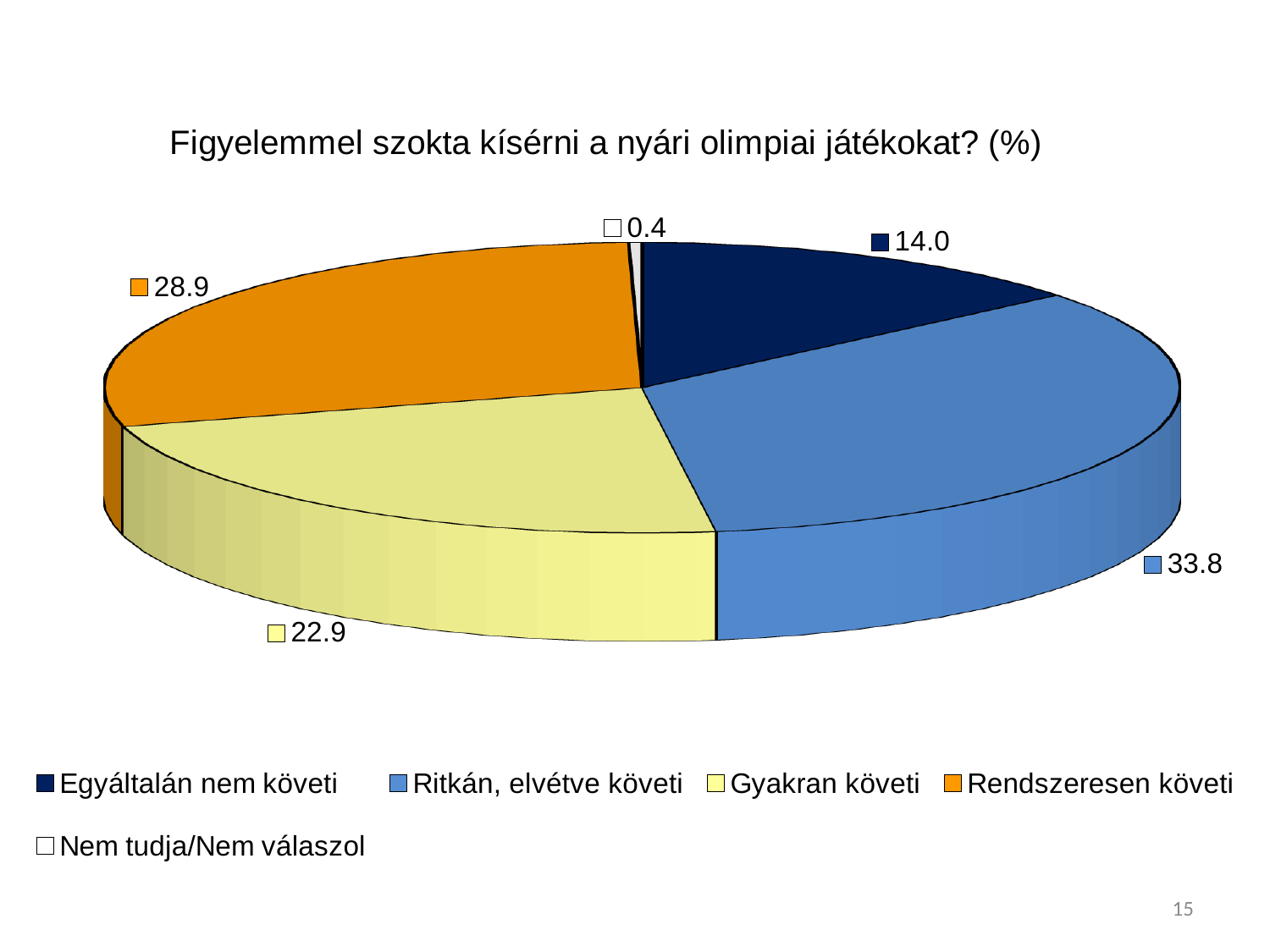
What is the value for "Egyáltalán nem követi"? 14.0 Which category has the smallest share of the pie? Nem tudja/Nem válaszol What is the value for "Gyakran követi"? 22.9 What is the value for "Rendszeresen követi"? 28.9 What is the value for "Ritkán, elvétve követi"? 33.8 Which category has the largest share of the pie? Ritkán, elvétve követi What type of chart is shown on the slide? pie chart What is the title of the chart? Figyelemmel szokta kísérni a nyári olimpiai játékokat? (%) What is the value for "Nem tudja/Nem válaszol"? 0.4 What is the difference between the values for "Ritkán, elvétve követi" and "Rendszeresen követi"? 4.9 Which is larger, the value for "Gyakran követi" or the value for "Egyáltalán nem követi"? Gyakran követi How many categories does the legend list? 5